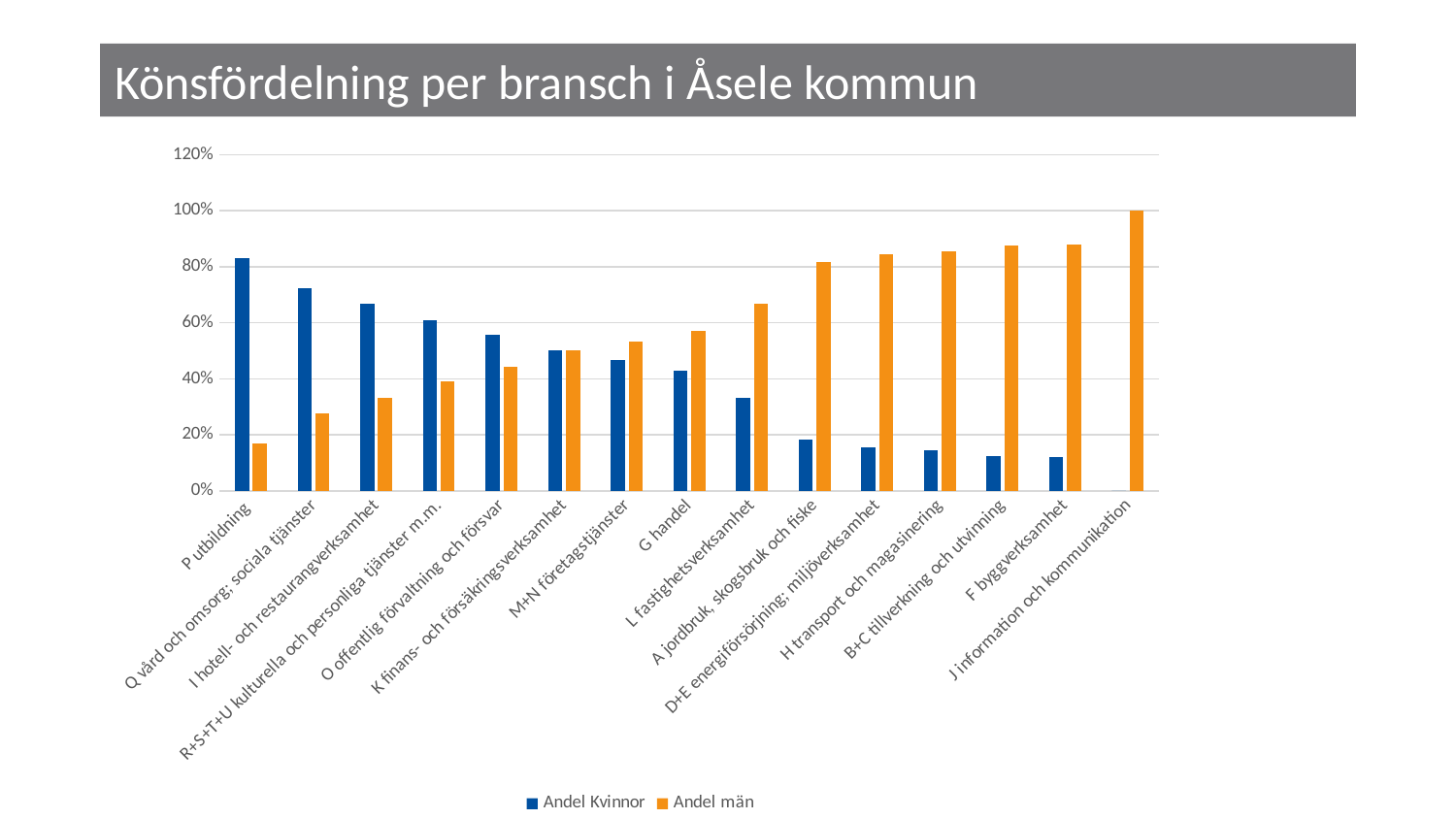
Is the value of Andel Kvinnor for Q vård och omsorg; sociala tjänster greater or less than 60%? greater Which category has the highest value for Andel Kvinnor? P utbildning How many series does the legend list? 2 How many industry categories are shown on the x axis? 15 Is the value of Andel Kvinnor for B+C tillverkning och utvinning greater or less than 20%? less What kind of chart is shown on the slide? Bar chart Which category has the highest value for Andel män? J information och kommunikation Which category has the lowest value for Andel män? P utbildning Do the Andel Kvinnor values rise or fall moving left to right along the x axis? Fall What is the value of Andel män for J information och kommunikation? 100% Is the value of Andel män for F byggverksamhet greater or less than 80%? greater For G handel, which is larger: Andel Kvinnor or Andel män? Andel män